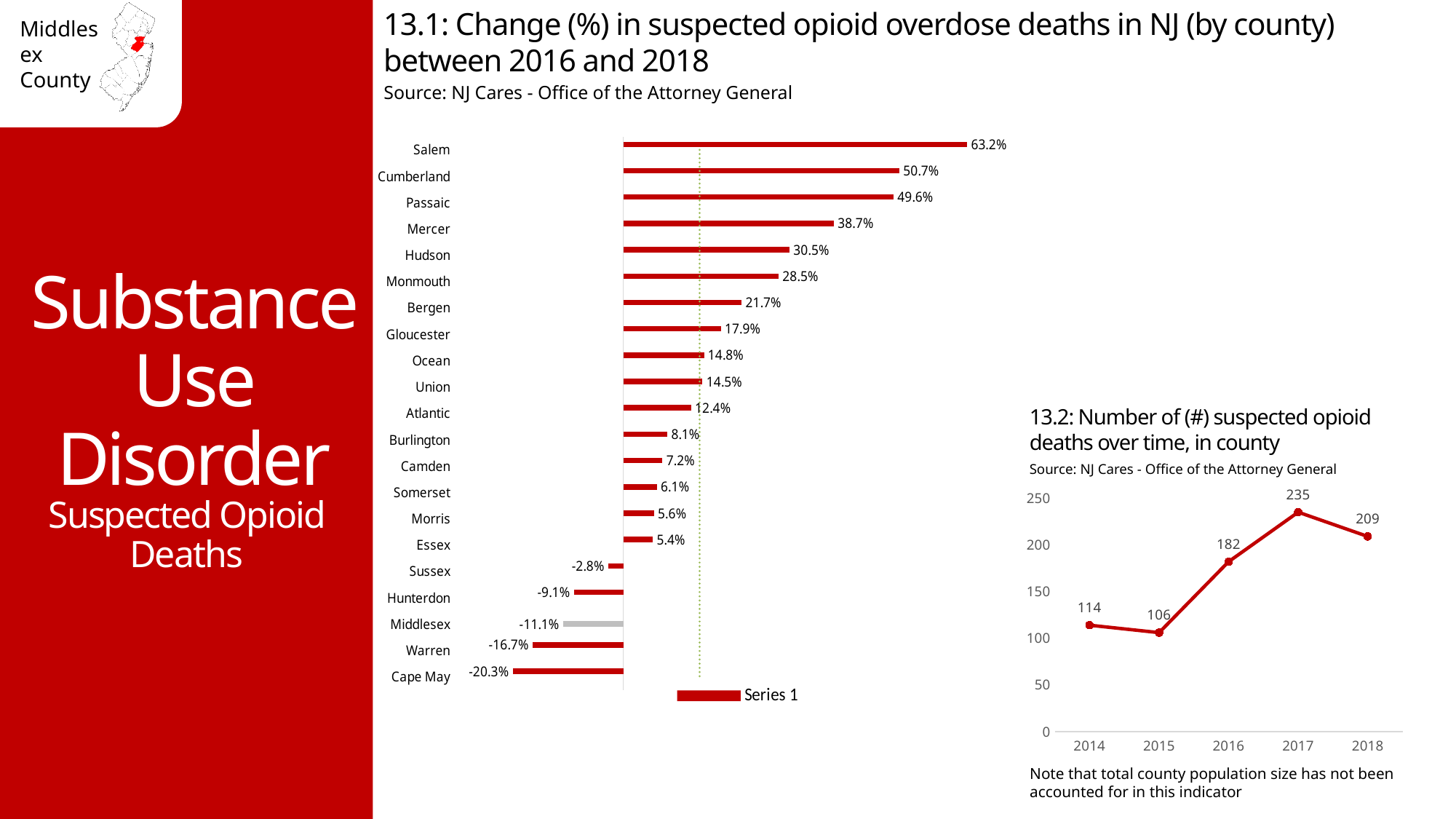
In chart 13.2 (number of suspected opioid deaths over time), what is the value for 2017? 235 In chart 13.1, which county has the highest change in suspected opioid overdose deaths? Salem In chart 13.1, which county has the lowest change in suspected opioid overdose deaths? Cape May In chart 13.2, which year has the lowest number of suspected opioid deaths? 2015 In chart 13.2, what type of chart is used? Line chart In chart 13.1, what is the value for Passaic? 49.6% In chart 13.1, what is the difference between the values for Salem and Cumberland? 12.5% In chart 13.1 (change in suspected opioid overdose deaths by county), what is the value for Middlesex? -11.1% In chart 13.1, which is larger, the value for Hudson or the value for Monmouth? Hudson In chart 13.2, what is the difference between the values for 2017 and 2018? 26 In chart 13.1, what type of chart is used? Bar chart In chart 13.1, how many counties are shown? 21